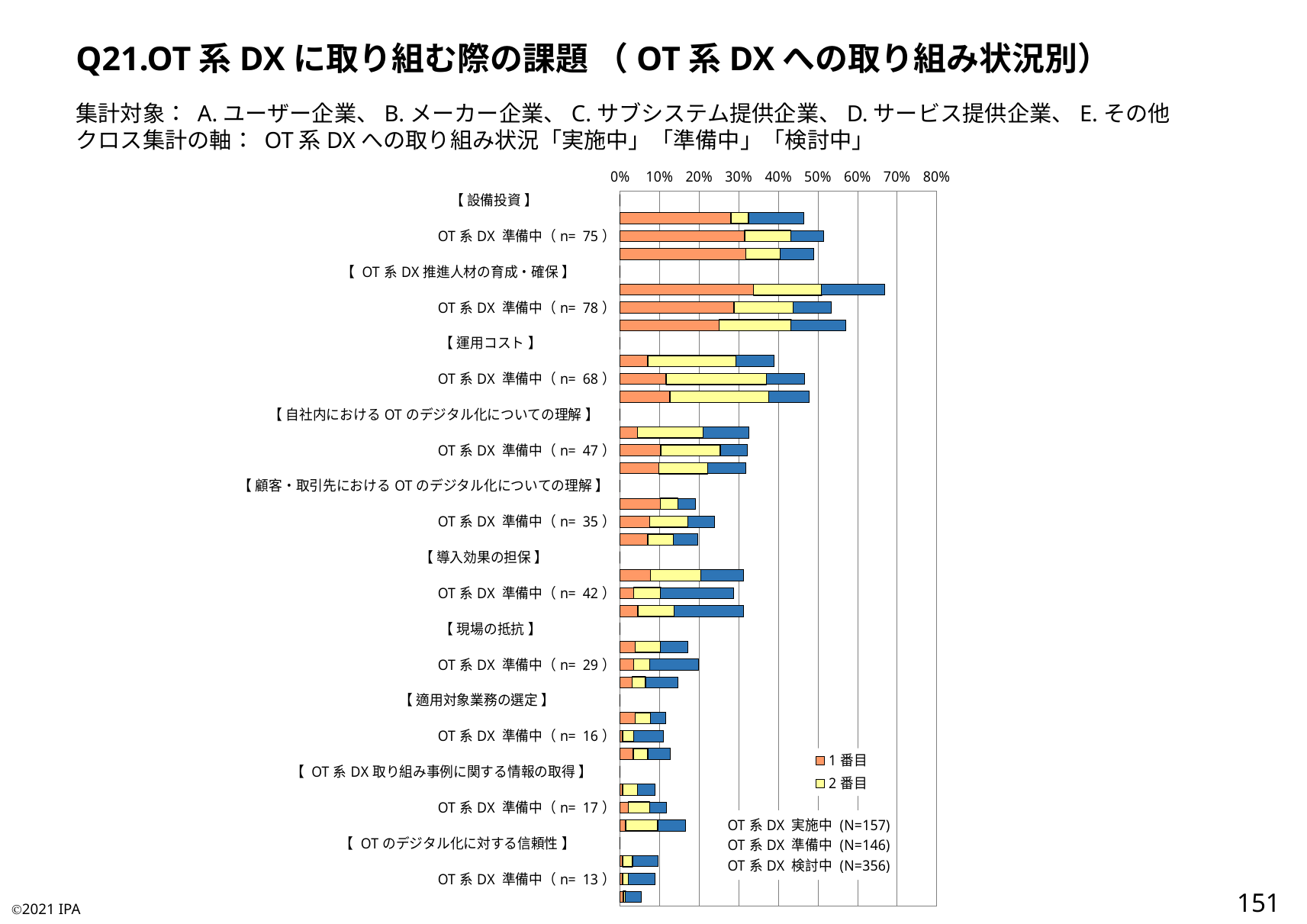
Which has the longer first bar (実施中): 【導入効果の担保】 or 【現場の抵抗】? 導入効果の担保 What kind of chart is shown on the slide? Stacked bar chart What is the n value shown for OT系DX 準備中 under 【設備投資】? n=75 Which has the longer first bar (実施中): 【設備投資】 or 【運用コスト】? 設備投資 Is the total length of the first bar (実施中) under 【設備投資】 greater or less than 40%? greater How many challenge categories (the bracketed headings such as 【設備投資】) are listed on the chart? 10 Is the total length of the last bar (検討中) under 【OTのデジタル化に対する信頼性】 greater or less than 10%? less Is the total length of the first bar (実施中) under 【適用対象業務の選定】 greater or less than 20%? less How many bars are plotted under each challenge category heading? 3 What is the N value shown for OT系DX 検討中 in the chart's note? N=356 Which challenge category contains the longest bar on the chart? OT系DX推進人材の育成・確保